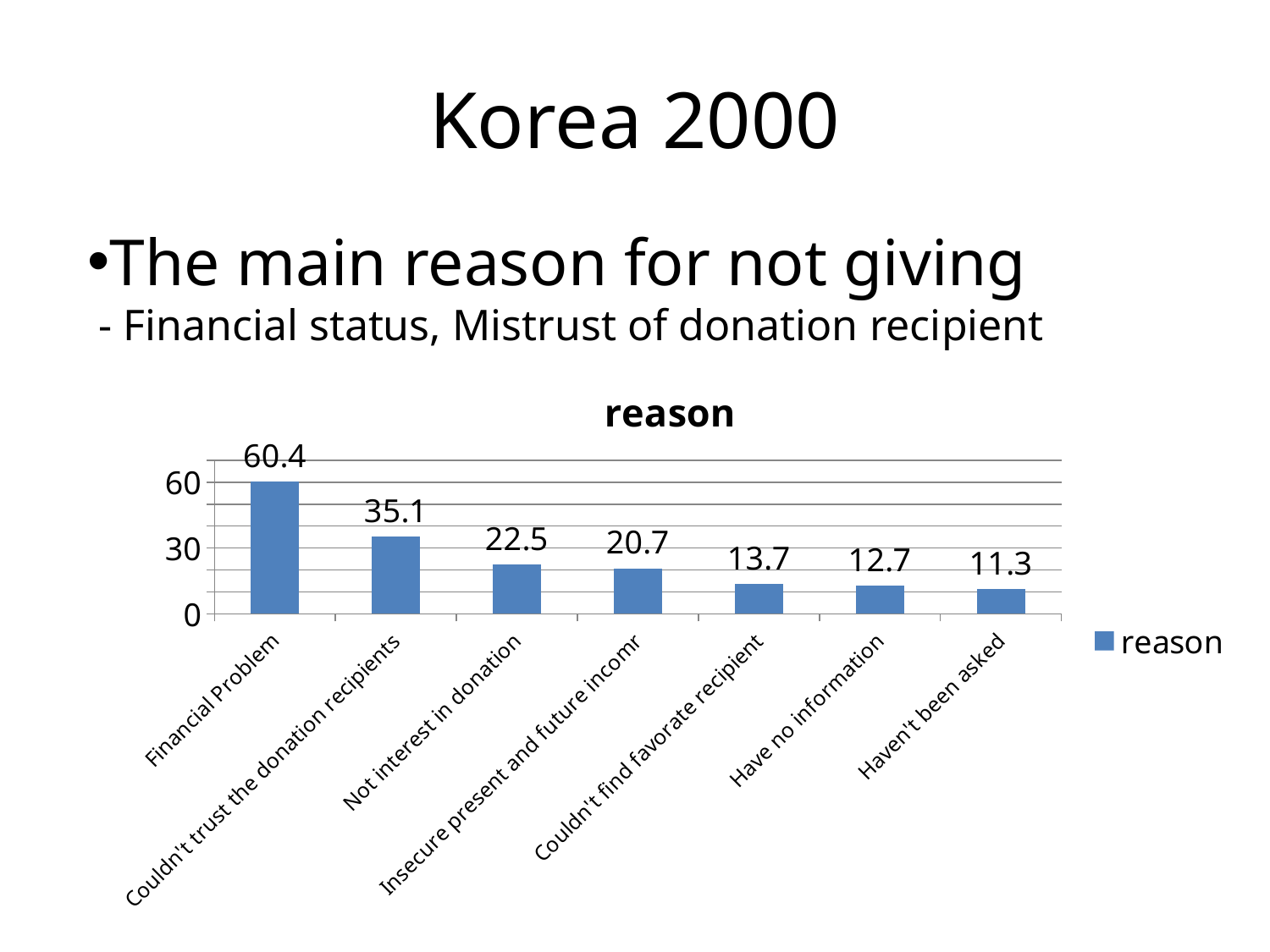
What is the value for Financial Problem? 60.4 What is the value for Have no information? 12.7 Is the value for Insecure present and future incomr greater or less than 30? less Which category has the lowest value? Haven't been asked What is the value for Couldn't trust the donation recipients? 35.1 What is the difference between the values for Financial Problem and Couldn't trust the donation recipients? 25.3 What kind of chart is shown? bar chart What is the value for Haven't been asked? 11.3 How many categories are shown on the x axis? 7 What is the title of the chart? reason Which category has the highest value? Financial Problem Which is larger, the value for Not interest in donation or the value for Couldn't find favorate recipient? Not interest in donation